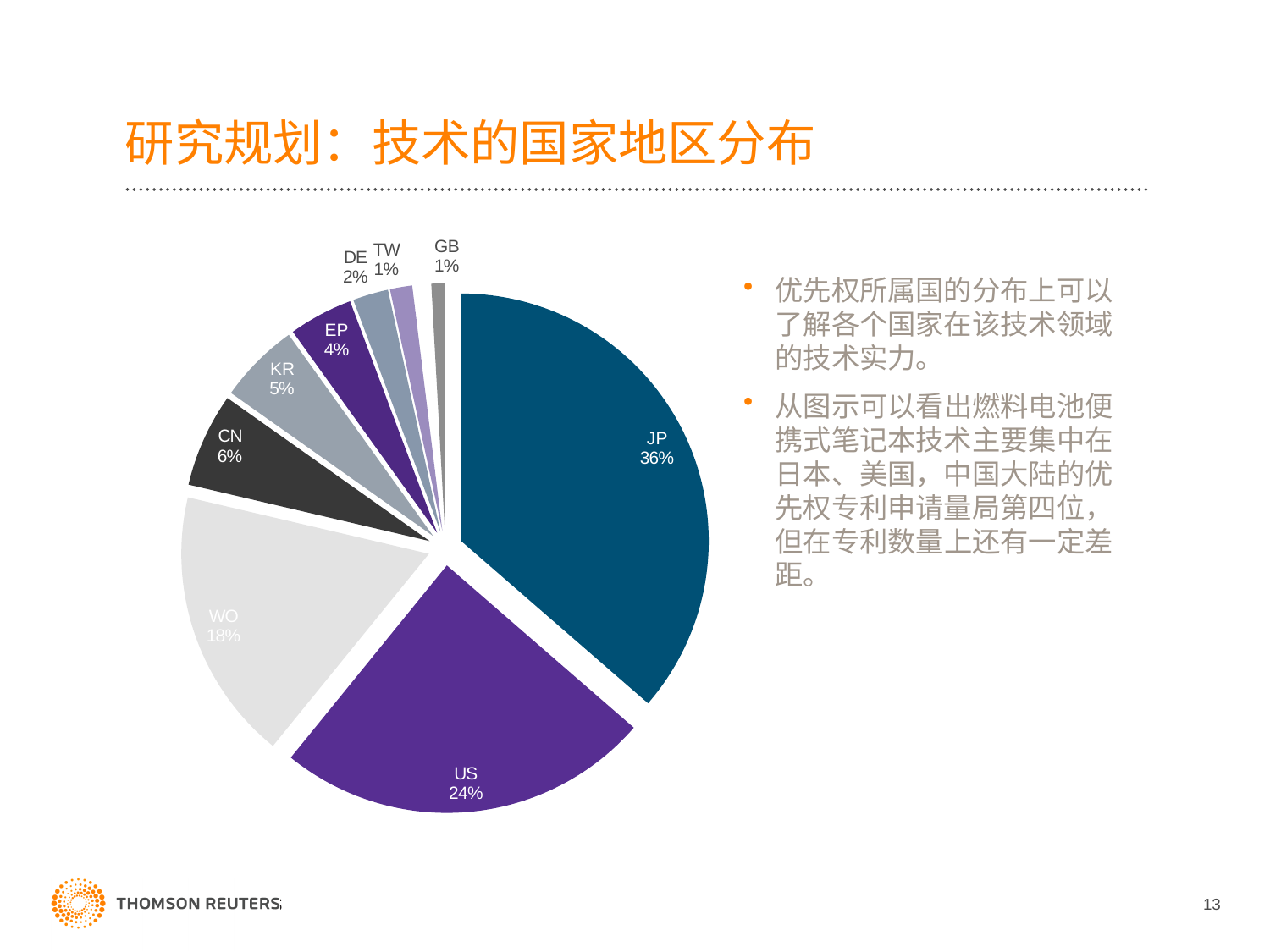
What kind of chart is shown on the slide? pie chart What share of the pie does JP have? 36% What is the value shown for KR? 5% Which category has the largest slice of the pie? JP What is the value shown for WO? 18% Which is larger, the share for CN or the share for KR? CN What is the difference between the WO and CN shares? 12% What is the value shown for EP? 4% What is the difference between the JP and US shares? 12% How many slices does the pie chart have? 10 What is the value shown for US? 24% What is the value shown for CN? 6%